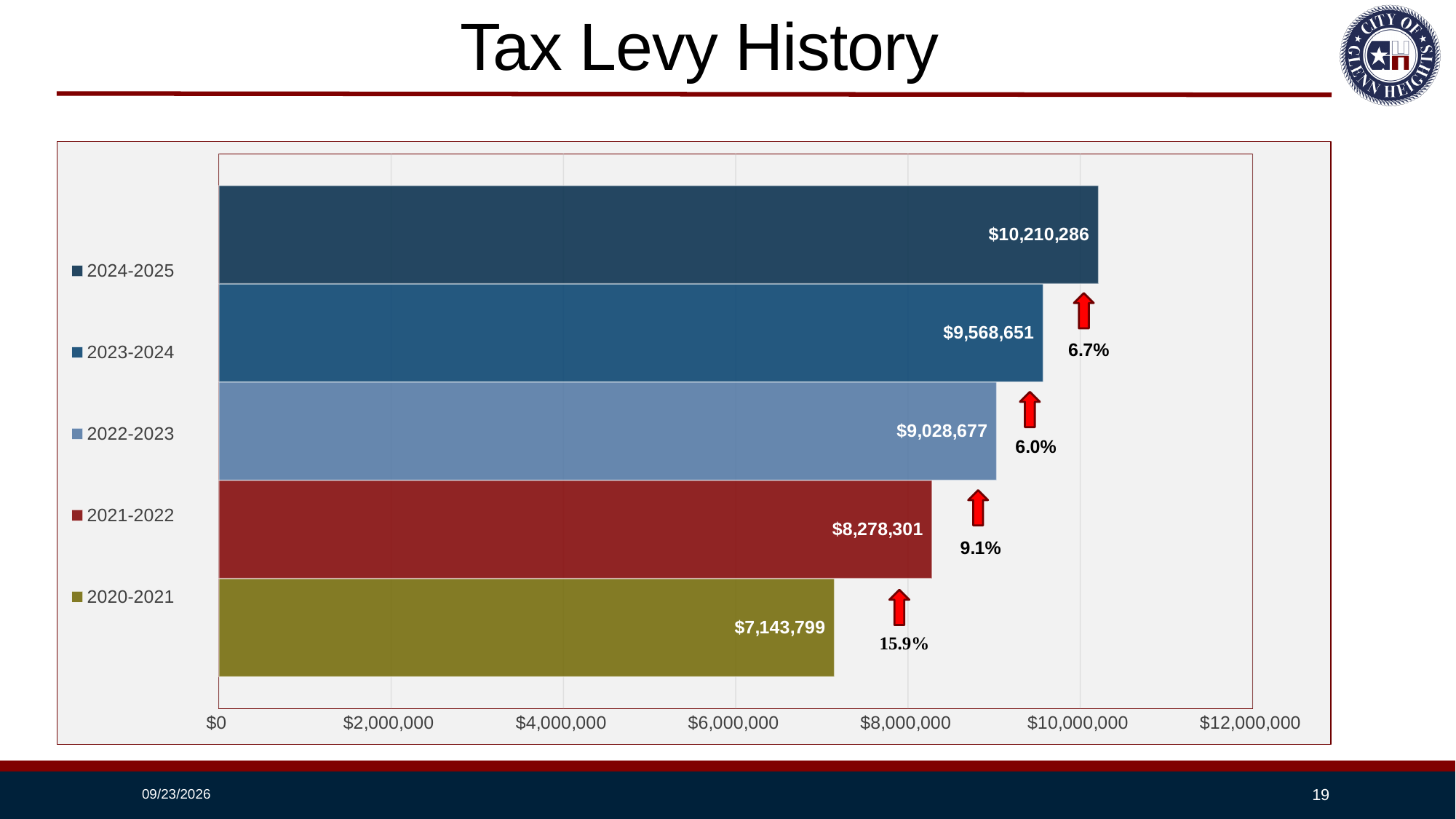
What is the difference between the tax levy for 2024-2025 and 2023-2024? $641,635 What is the tax levy value shown for 2024-2025? $10,210,286 How many series does the legend list? 5 What is the tax levy value shown for 2022-2023? $9,028,677 What kind of chart is shown on the slide? bar chart Which is larger, the tax levy for 2022-2023 or for 2021-2022? 2022-2023 Which year has the lowest tax levy? 2020-2021 What is the difference between the tax levy for 2021-2022 and 2020-2021? $1,134,502 Which year has the highest tax levy? 2024-2025 What percentage increase is annotated between 2020-2021 and 2021-2022? 15.9% What is the tax levy value shown for 2020-2021? $7,143,799 Is the tax levy for 2023-2024 greater or less than $10,000,000? less